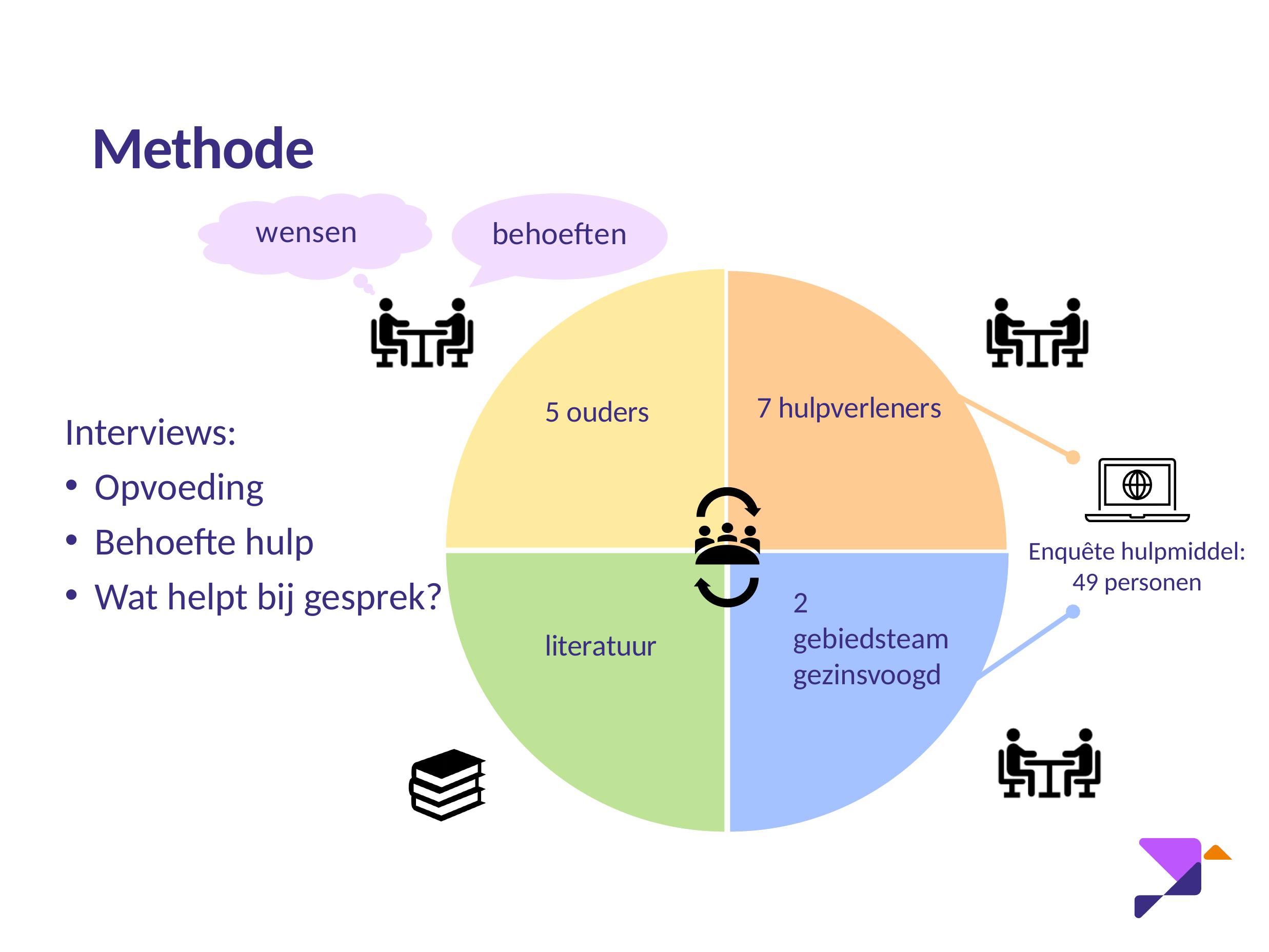
How many ouders are mentioned in the pie chart? 5 What is the label of the orange segment of the pie chart? 7 hulpverleners What is the label of the green segment of the pie chart? literatuur What is the label of the yellow segment of the pie chart? 5 ouders What kind of chart is shown on the slide? pie chart What is the label of the blue segment of the pie chart? 2 gebiedsteam gezinsvoogd How many personen took part in the 'Enquête hulpmiddel' noted next to the pie chart? 49 What colour is the 'literatuur' segment of the pie chart? green How many hulpverleners are mentioned in the pie chart? 7 How many segments does the pie chart have? 4